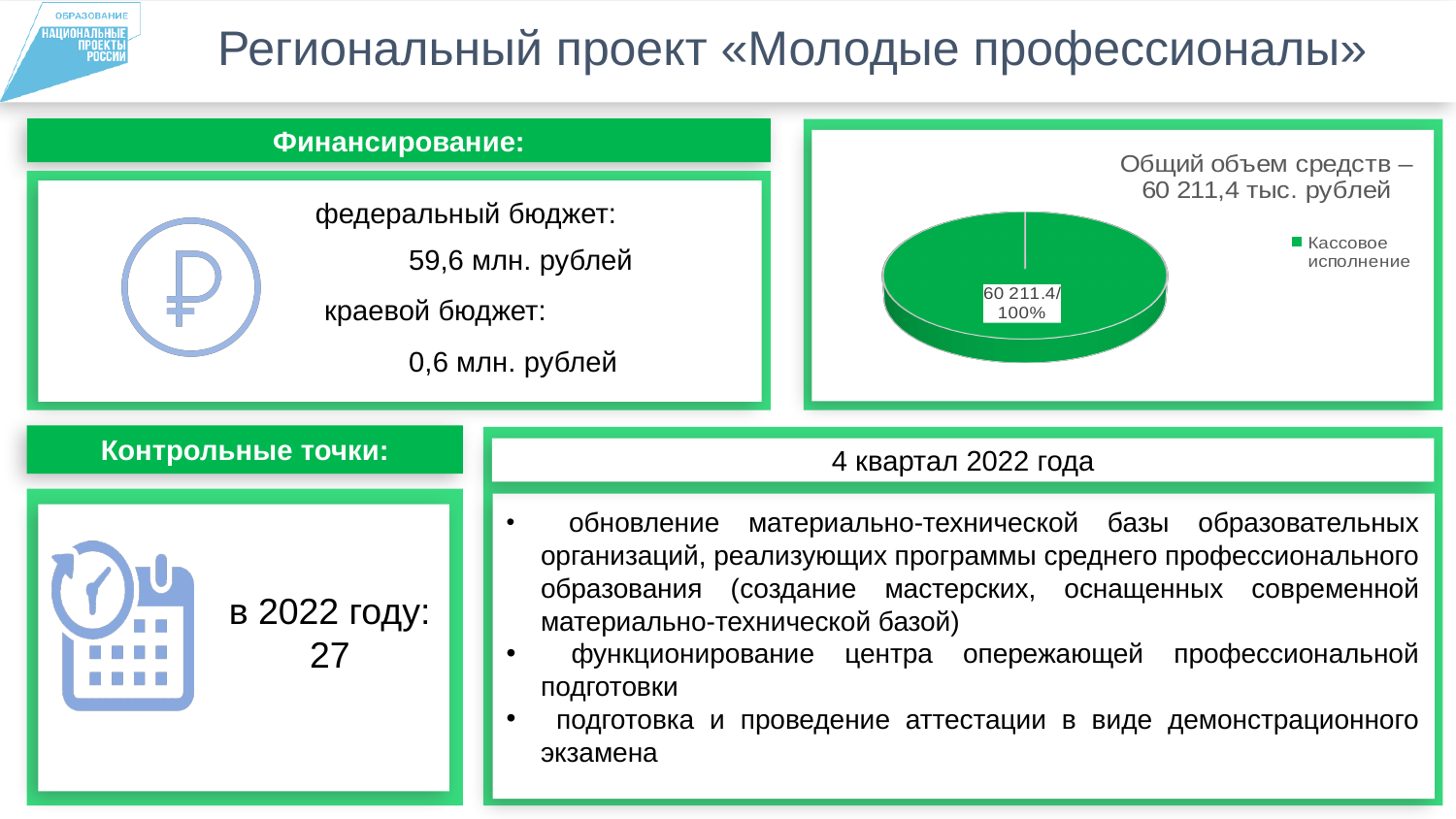
How many slices does the pie chart have? 1 What is the legend entry of the pie chart? Кассовое исполнение What kind of chart is shown on the slide? pie chart What is the total volume of funds stated in the pie chart title? 60 211,4 тыс. рублей How many entries does the legend of the pie chart list? 1 What value is printed on the slice for Кассовое исполнение in the pie chart? 60 211.4 What is the title of the pie chart? Общий объем средств – 60 211,4 тыс. рублей What share of the pie does the Кассовое исполнение slice represent? 100%